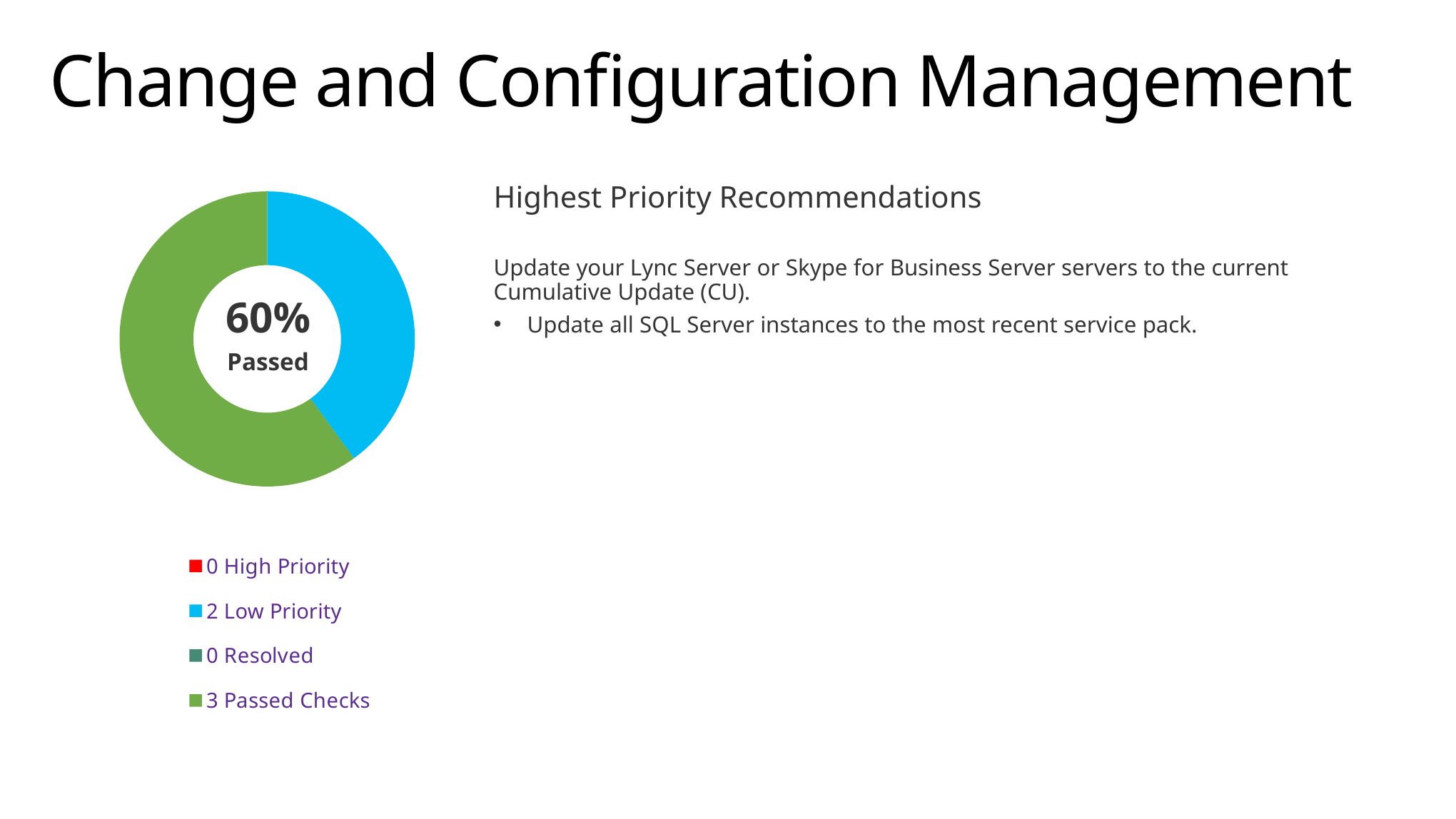
What is the total number of checks across all legend categories? 5 What is the difference between the number of Passed Checks and the number of Low Priority items? 1 How many Resolved items does the legend show? 0 How many High Priority items does the legend show? 0 Which is larger, the number of Passed Checks or the number of Low Priority items? Passed Checks How many Low Priority items does the legend show? 2 How many entries does the legend list? 4 What kind of chart is shown on the slide? Doughnut chart How many Passed Checks does the legend show? 3 What colour represents Passed Checks in the chart? Green What percentage is shown in the centre of the doughnut chart? 60% Which category has the highest count in the chart? Passed Checks